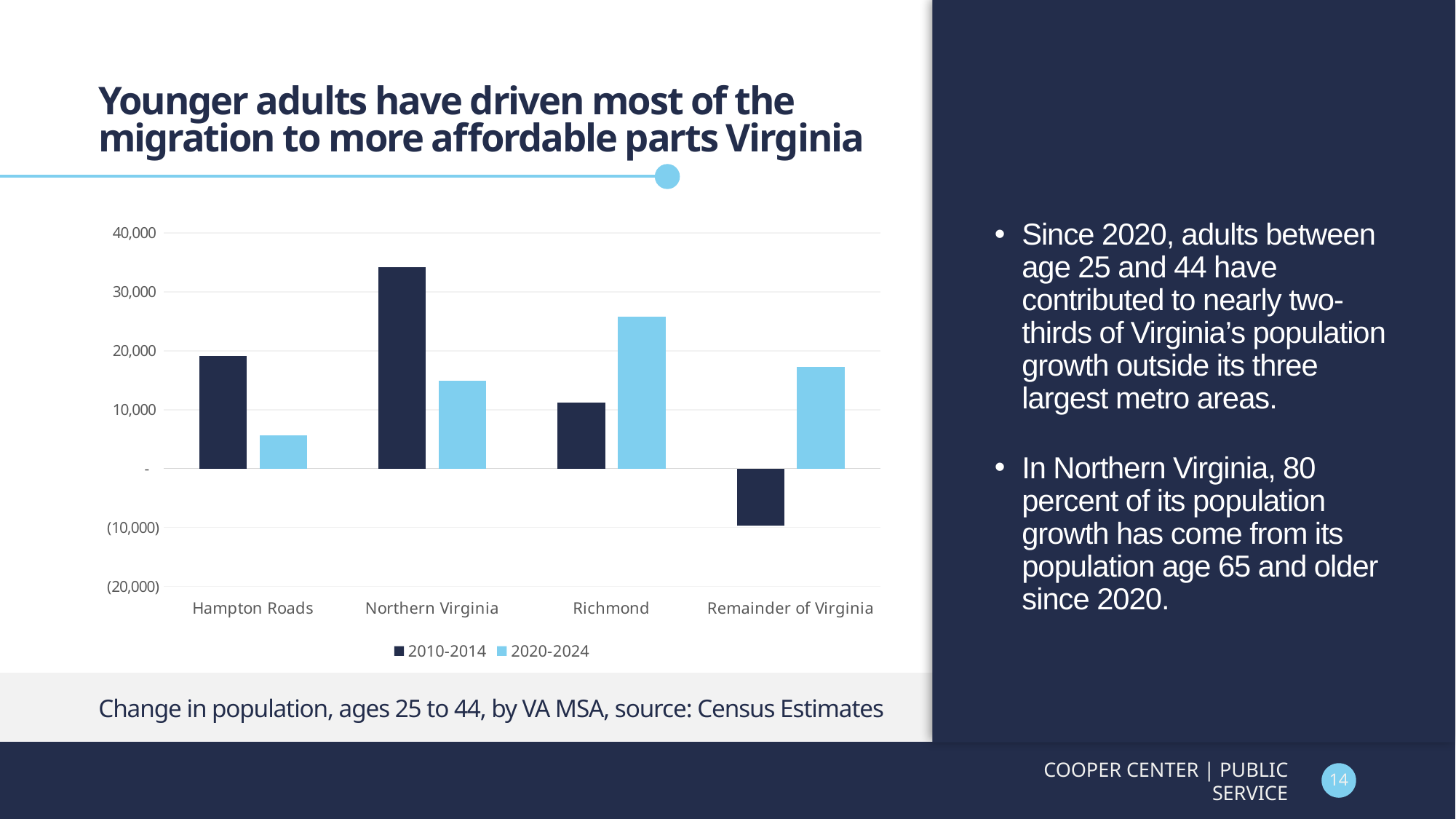
Which region has the lowest value for the 2020-2024 series? Hampton Roads How many regions (categories) are shown on the x axis of the chart? 4 Which region has the lowest value for the 2010-2014 series? Remainder of Virginia What kind of chart is shown on the slide? bar chart Which region has the highest value for the 2020-2024 series? Richmond For Richmond, which series has the larger value, 2010-2014 or 2020-2024? 2020-2024 How many series does the chart's legend list? 2 Is the 2010-2014 value for Northern Virginia greater or less than 30,000? greater Which region shows a negative value for the 2010-2014 series? Remainder of Virginia For Hampton Roads, which series has the larger value, 2010-2014 or 2020-2024? 2010-2014 Which region has the highest value for the 2010-2014 series? Northern Virginia Is the 2020-2024 value for Hampton Roads greater or less than 10,000? less